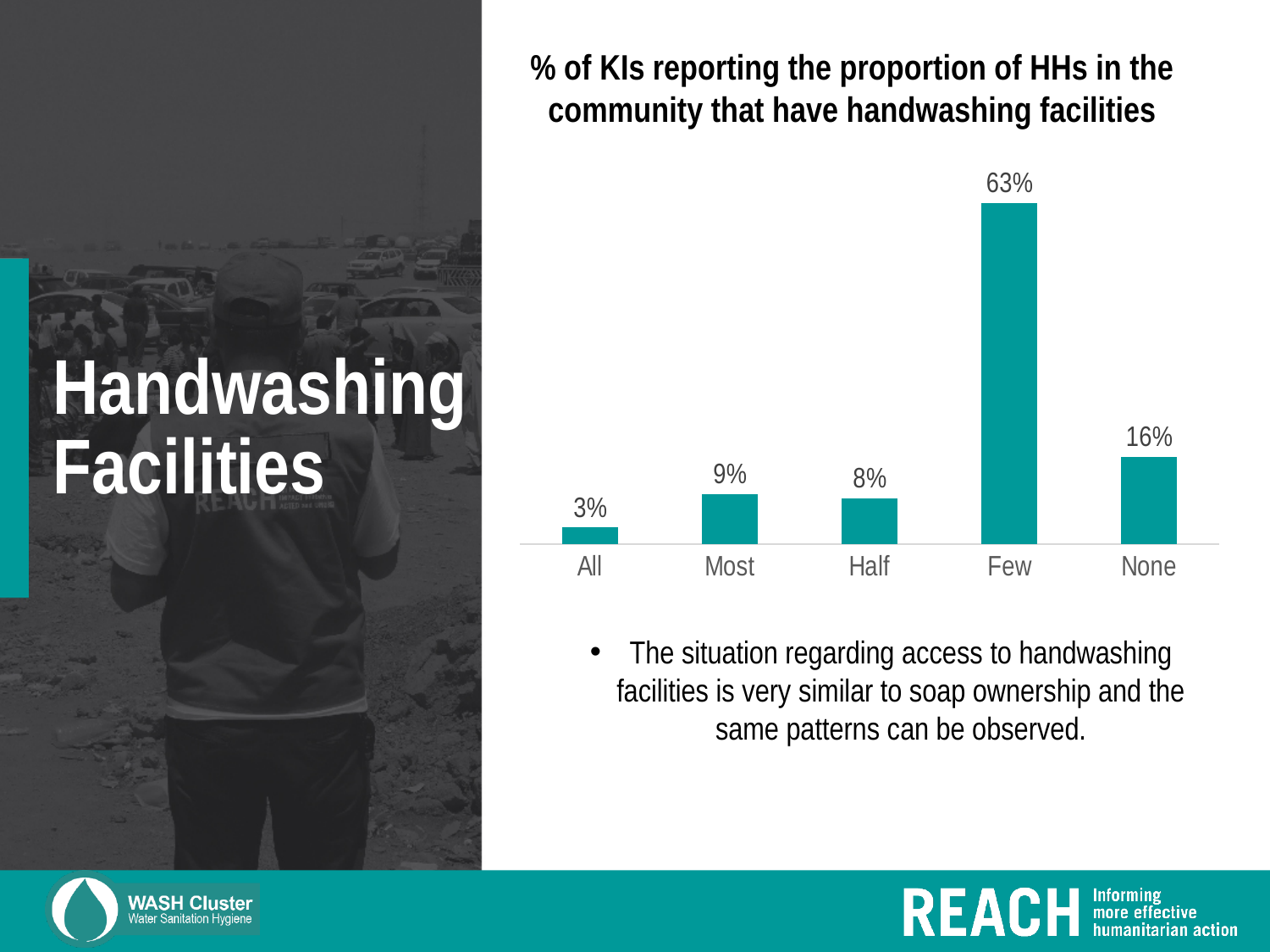
What is the value shown for the 'None' category? 16% What is the difference between the values for 'Few' and 'None'? 47% What type of chart is shown on the slide? Bar chart What is the value shown for the 'All' category? 3% Which category has the lowest value? All Which category has the highest value? Few How many categories are shown on the x axis of the chart? 5 What is the value shown for the 'Most' category? 9% What percentage of KIs reported that few households in the community have handwashing facilities? 63% What is the title of the chart? % of KIs reporting the proportion of HHs in the community that have handwashing facilities Which has a larger value, 'None' or 'Most'? None What is the difference between the values for 'Most' and 'Half'? 1%